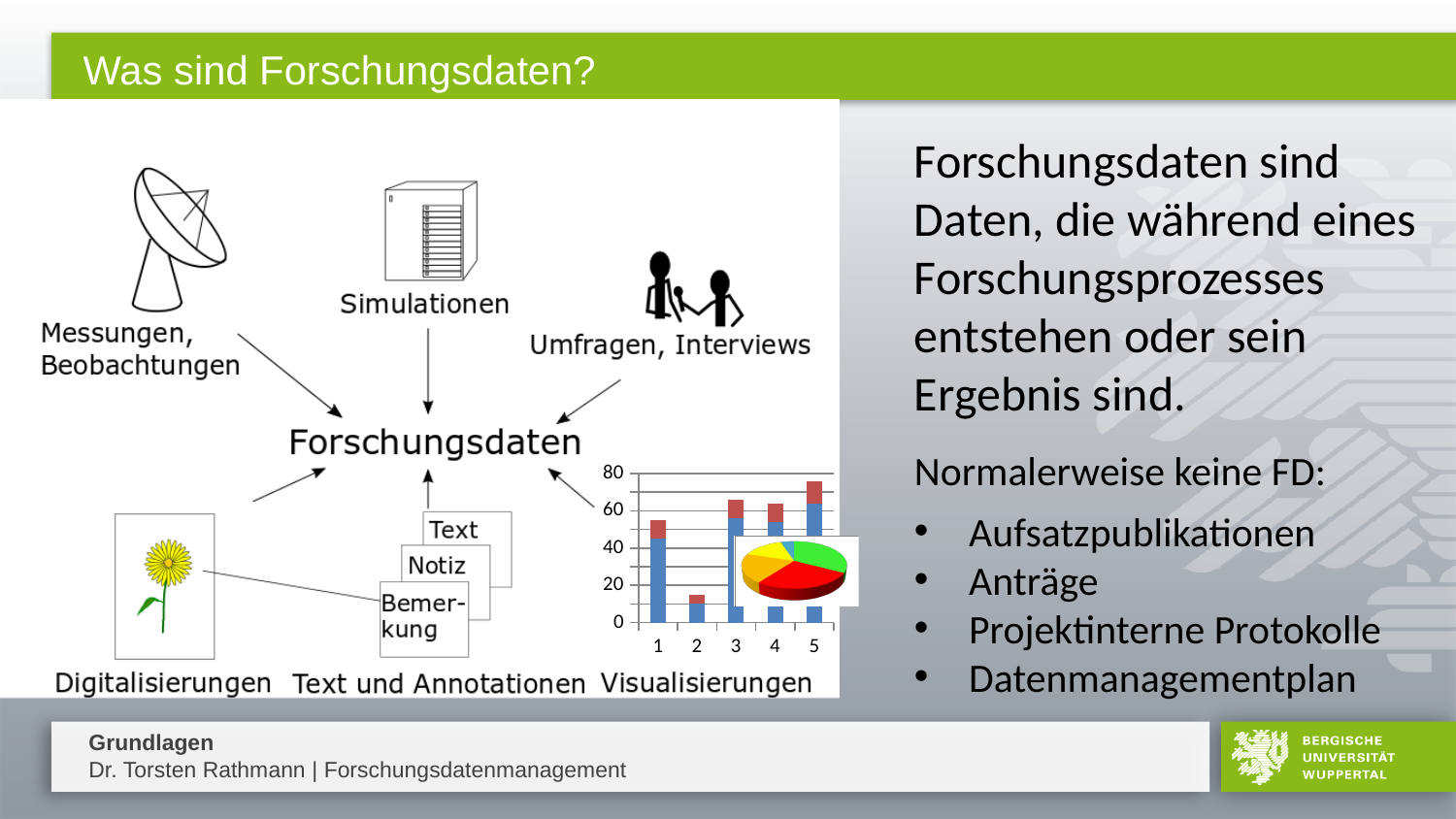
Which category has the tallest bar in the bar chart? 5 Is the value for category 1 in the bar chart greater or less than 40? greater What other type of chart is overlaid on the bar chart? pie chart What kind of chart is the chart labelled 'Visualisierungen' with the numbered x axis? bar chart Is the value for category 5 in the bar chart greater or less than 60? greater In the bar chart, which is larger, the bar for category 3 or the bar for category 2? category 3 Which category has the shortest stacked bar in the bar chart? 2 What is the highest value shown on the y axis of the bar chart? 80 Is the value for category 2 in the bar chart greater or less than 20? less How many categories are shown on the x axis of the bar chart? 5